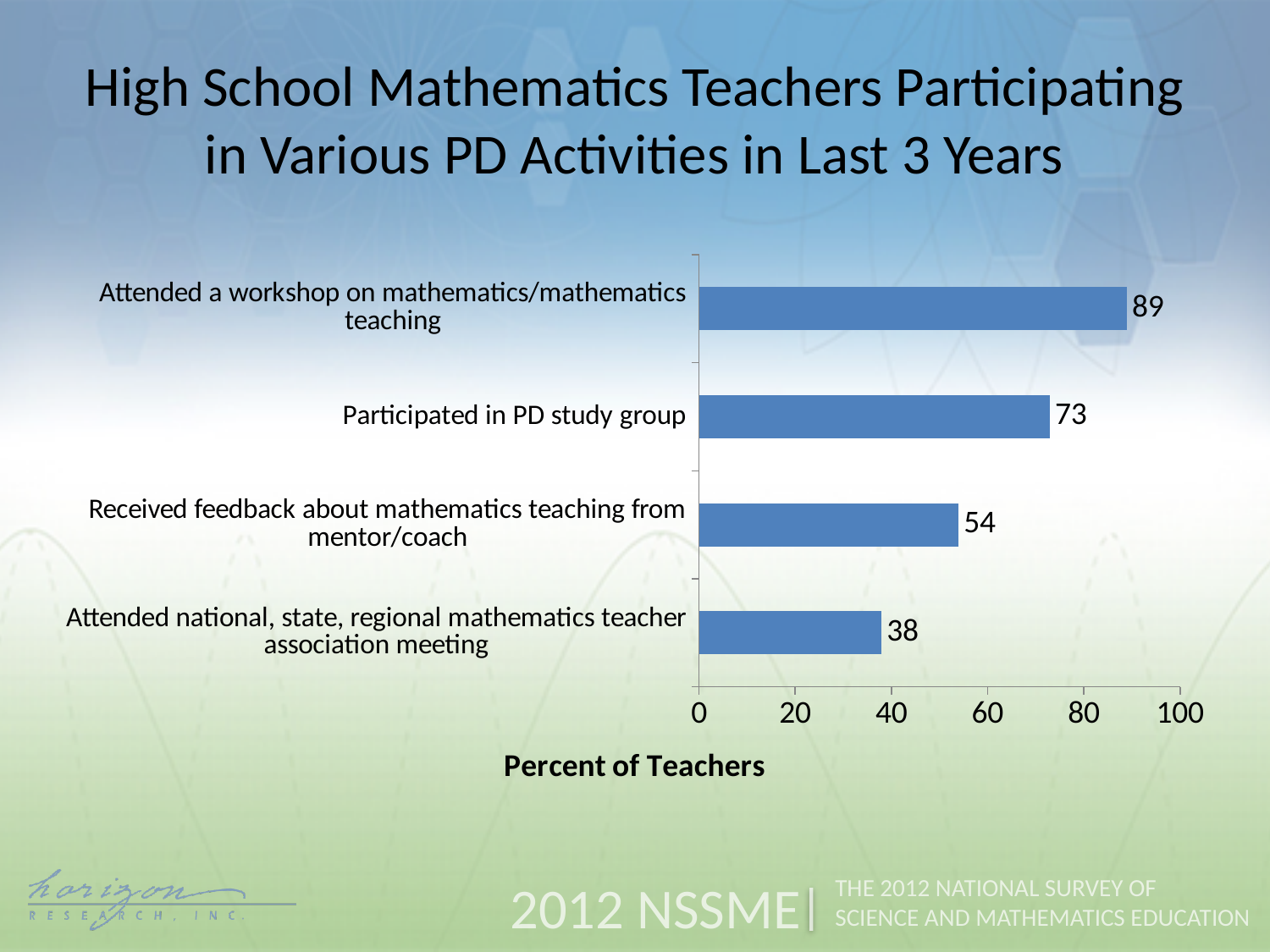
What percent of teachers received feedback about mathematics teaching from a mentor/coach? 54 Which PD activity has the lowest percent of teachers? Attended national, state, regional mathematics teacher association meeting What percent of teachers attended a workshop on mathematics/mathematics teaching? 89 What is the difference in percent of teachers between attending a workshop and attending a teacher association meeting? 51 What is the difference in percent of teachers between participating in a PD study group and receiving feedback from a mentor/coach? 19 How many PD activities are shown in the chart? 4 What is the label of the horizontal axis? Percent of Teachers What percent of teachers attended a national, state, regional mathematics teacher association meeting? 38 What percent of teachers participated in a PD study group? 73 Which is larger: the percent who participated in a PD study group or the percent who received feedback from a mentor/coach? Participated in PD study group Which PD activity has the highest percent of teachers? Attended a workshop on mathematics/mathematics teaching What kind of chart is shown on the slide? Bar chart